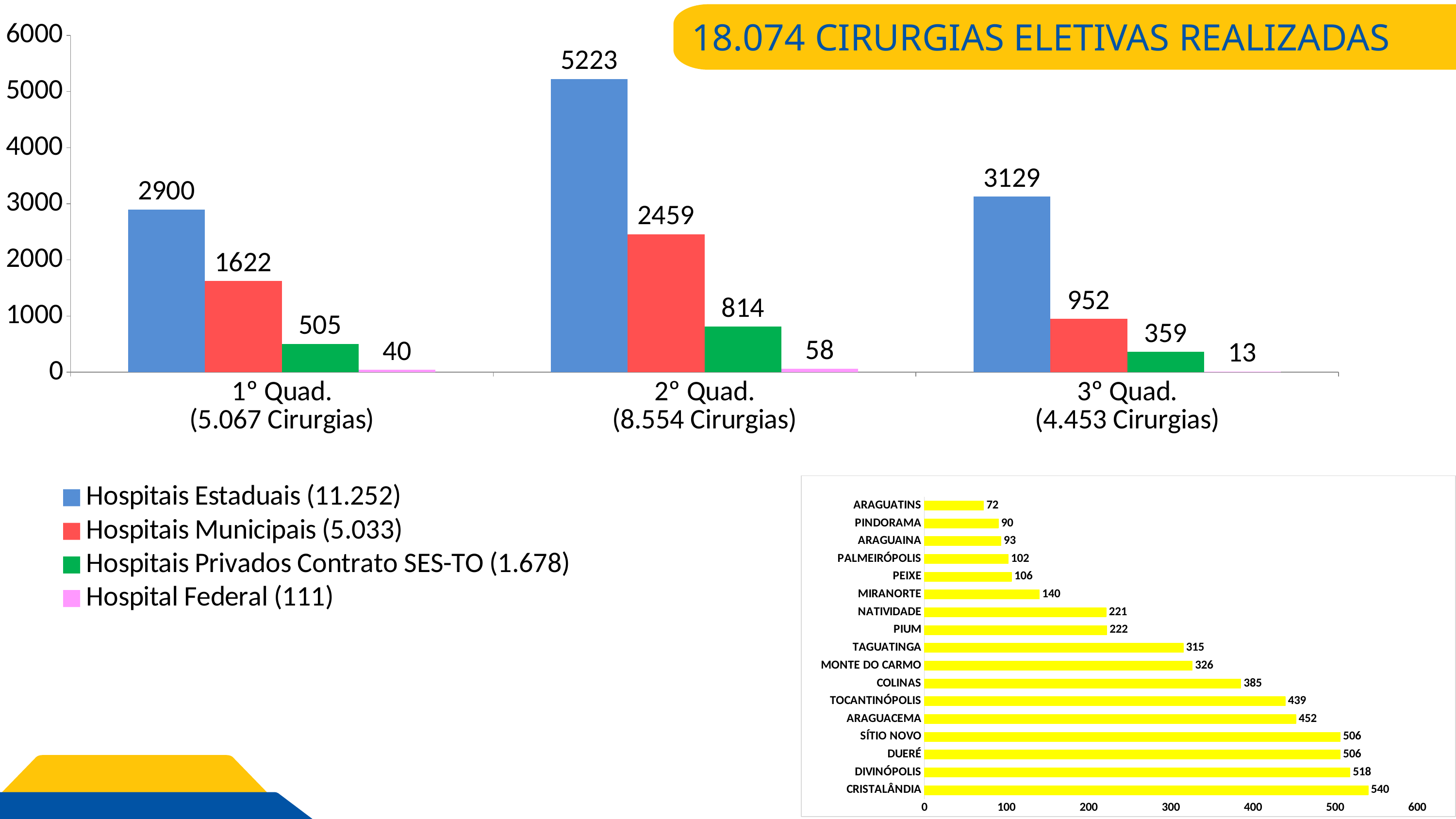
In the top chart, what is the value for Hospitais Estaduais in 2° Quad.? 5223 In the top chart, what colour represents Hospital Federal? Pink In the bottom-right chart, which municipality has the lowest value? ARAGUATINS In the top chart, how many series does the legend list? 4 In the bottom-right chart, how many municipalities are shown? 17 In the top chart, what is the value for Hospital Federal in 3° Quad.? 13 In the top chart, which is larger: Hospitais Privados Contrato SES-TO in 2° Quad. or in 3° Quad.? 2° Quad. In the top chart, what is the difference between Hospitais Estaduais and Hospitais Municipais in 1° Quad.? 1278 In the bottom-right chart, which municipality has the highest value? CRISTALÂNDIA In the bottom-right chart, what is the value for MIRANORTE? 140 In the top chart, which quadrimestre has the highest value for Hospitais Municipais? 2° Quad. What kind of chart is the bottom-right chart? Bar chart